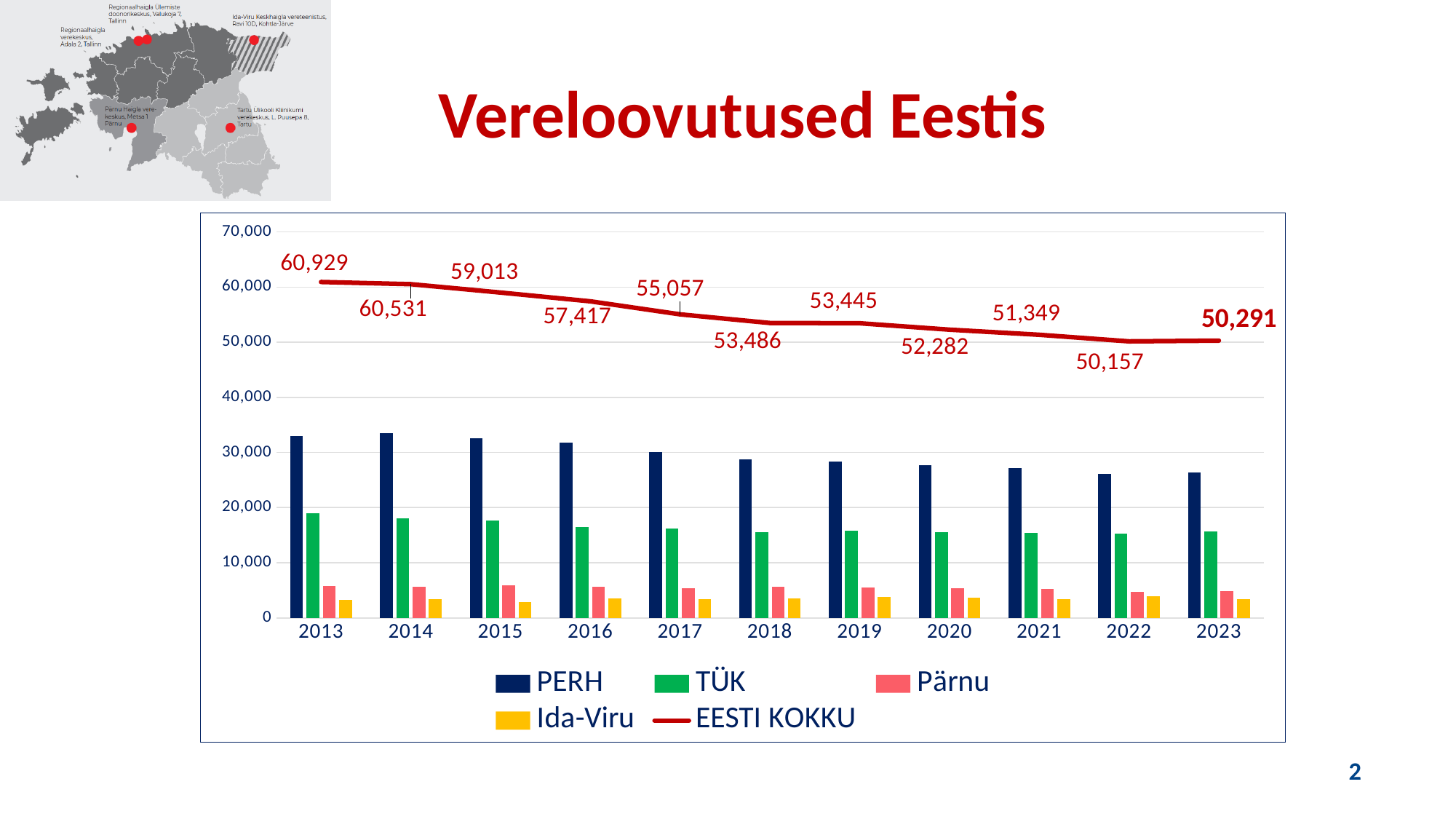
What is the EESTI KOKKU value for 2013? 60,929 In which year is the EESTI KOKKU line at its highest? 2013 How many series does the legend list? 5 Which is larger, the EESTI KOKKU value for 2016 or for 2017? 2016 Does the EESTI KOKKU line generally rise or fall from 2013 to 2023? fall What is the difference between the EESTI KOKKU values for 2013 and 2023? 10,638 In which year is the EESTI KOKKU line at its lowest? 2022 How many years are shown on the x axis? 11 What is the EESTI KOKKU value for 2023? 50,291 What is the EESTI KOKKU value for 2018? 53,486 Is the value for PERH in 2013 greater or less than 30,000? greater Is the value for TÜK in 2023 greater or less than 20,000? less